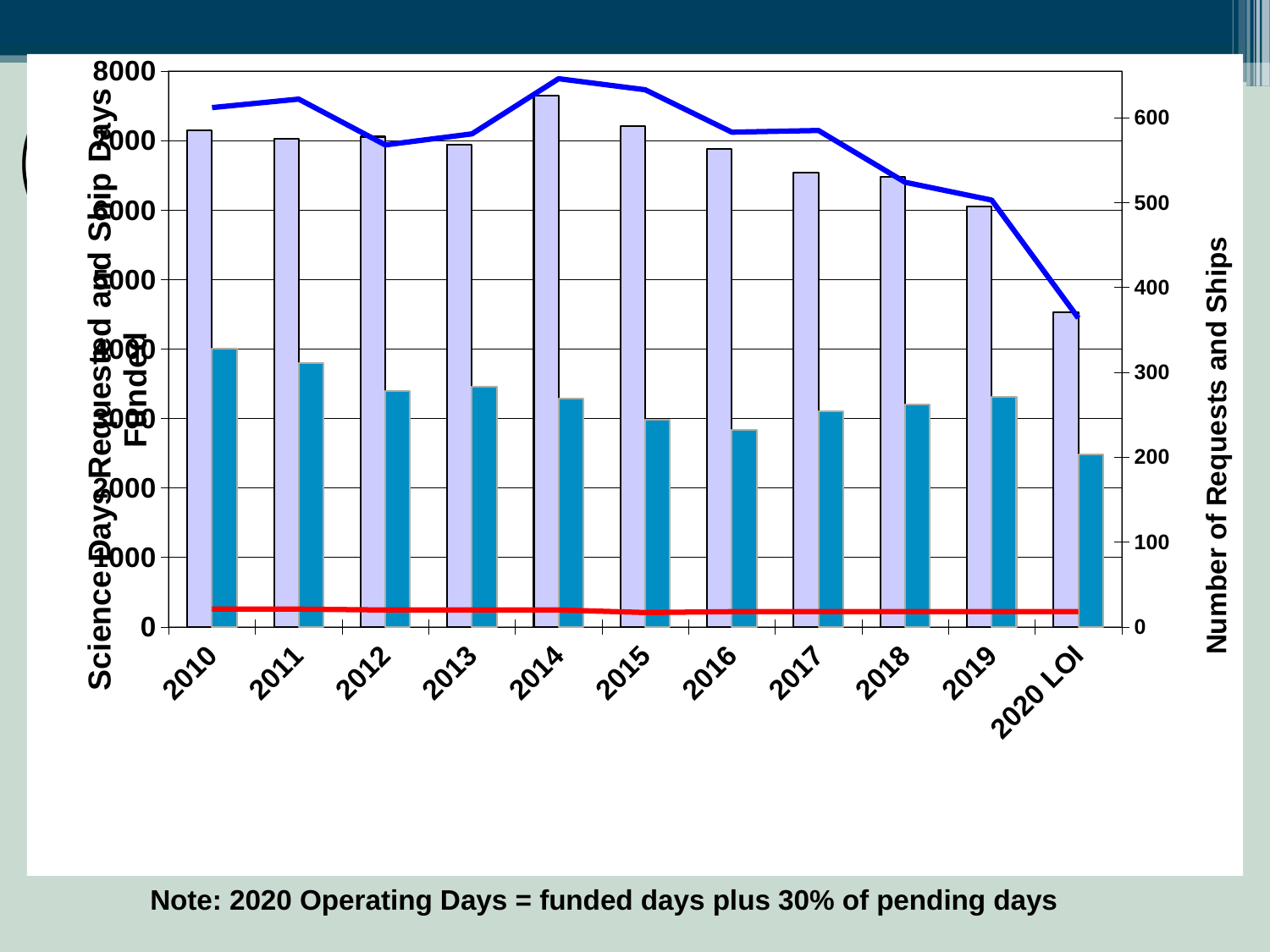
Which is larger, the light purple bar for 2010 or the light purple bar for 2017? 2010 Is the light purple bar for 2020 LOI greater or less than 4000 on the left axis? greater Is the teal bar for 2016 greater or less than 2500 on the left axis? greater What kind of chart is shown on the slide? A combined bar and line chart Is the light purple bar for 2014 greater or less than 7000 on the left axis? greater Which category has the tallest teal bar? 2010 Which category has the tallest light purple bar? 2014 Does the blue line rise or fall from 2017 to 2020 LOI? fall Which category has the shortest light purple bar? 2020 LOI Which category has the shortest teal bar? 2020 LOI What is the title of the right-hand vertical axis? Number of Requests and Ships How many categories are shown on the x axis of the chart? 11